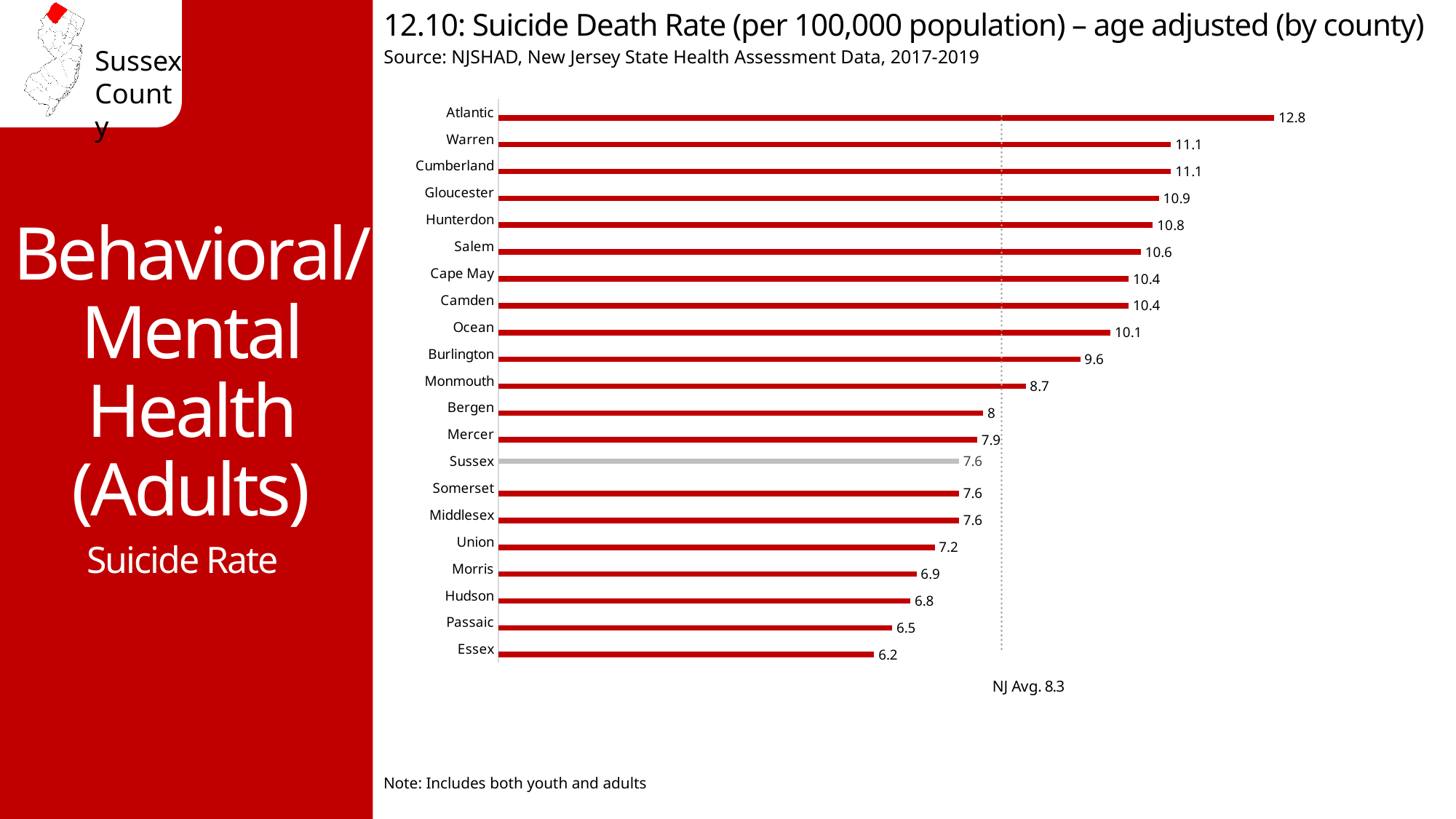
Which county's bar is shown in grey rather than red? Sussex What is the difference between the suicide death rates of Atlantic and Essex counties? 6.6 Which county has the lowest suicide death rate? Essex What is the difference between the suicide death rates of Sussex and Morris counties? 0.7 Which county has a higher suicide death rate, Burlington or Bergen? Burlington What is the suicide death rate for Sussex County? 7.6 How many counties are shown in the chart? 21 What is the suicide death rate for Hunterdon County? 10.8 What type of chart is shown on the slide? Bar chart What is the NJ average suicide death rate shown on the chart? 8.3 What is the suicide death rate for Atlantic County? 12.8 Which county has the highest suicide death rate? Atlantic